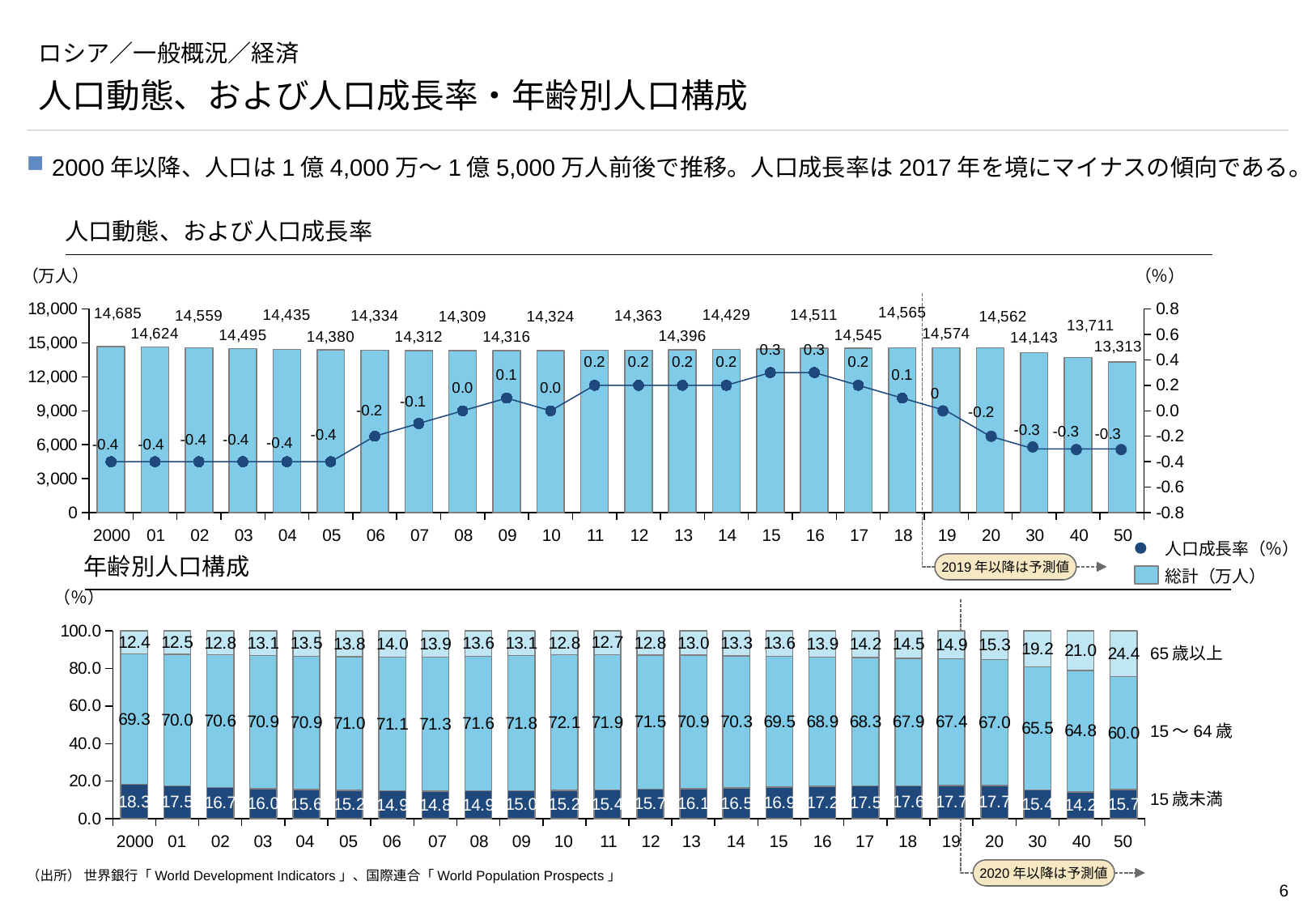
In the bottom chart (年齢別人口構成), what is the difference between the 65歳以上 share for 50 and for 2000? 12.0 In the top chart (人口動態、および人口成長率), which year has the lowest 総計 (万人)? 50 In the top chart (人口動態、および人口成長率), what kind of chart is it? A bar chart combined with a line In the top chart (人口動態、および人口成長率), what is the 総計 (万人) value for 50? 13,313 In the bottom chart (年齢別人口構成), what is the 65歳以上 share for 50? 24.4 In the bottom chart (年齢別人口構成), what is the 15～64歳 share for 10? 72.1 In the top chart (人口動態、および人口成長率), how many series does the legend list? 2 In the top chart (人口動態、および人口成長率), what is the 人口成長率 (%) for 15? 0.3 In the top chart (人口動態、および人口成長率), what is the 総計 (万人) value for 2000? 14,685 In the top chart (人口動態、および人口成長率), what is the 人口成長率 (%) for 2000? -0.4 In the bottom chart (年齢別人口構成), what is the 15歳未満 share for 2000? 18.3 In the bottom chart (年齢別人口構成), which year has the highest 65歳以上 share? 50